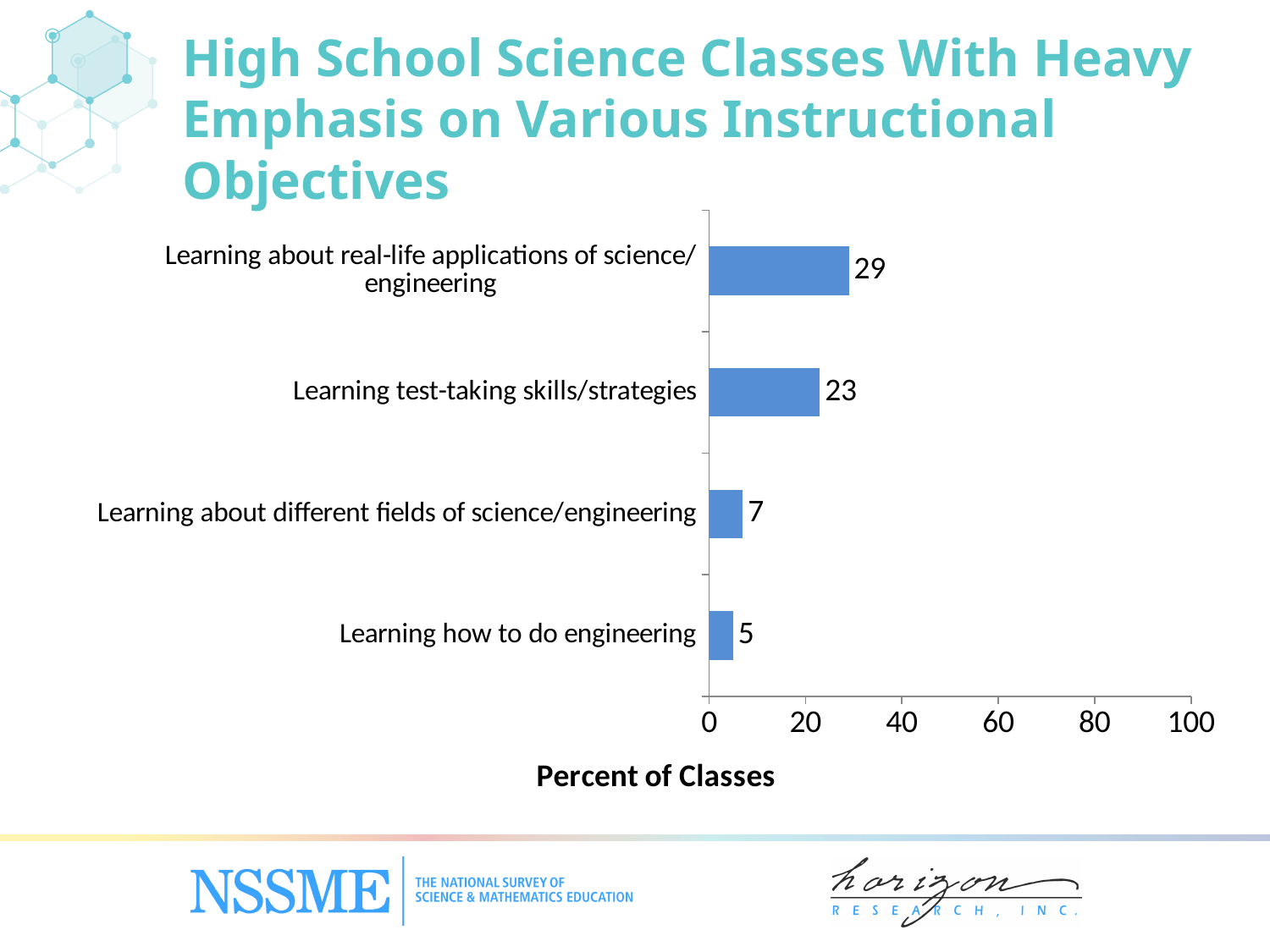
What kind of chart is shown on the slide? Bar chart Is the value for learning test-taking skills/strategies greater or less than 20? greater What percent of classes place heavy emphasis on learning test-taking skills/strategies? 23 How many instructional objectives are shown in the chart? 4 What percent of classes place heavy emphasis on learning about different fields of science/engineering? 7 What is the label of the horizontal axis? Percent of Classes What is the difference in percent of classes between learning about real-life applications of science/engineering and learning test-taking skills/strategies? 6 Which instructional objective has the highest percent of classes with heavy emphasis? Learning about real-life applications of science/engineering Which instructional objective has the lowest percent of classes with heavy emphasis? Learning how to do engineering What percent of classes place heavy emphasis on learning how to do engineering? 5 What percent of classes place heavy emphasis on learning about real-life applications of science/engineering? 29 Which has a higher percent of classes: learning about different fields of science/engineering or learning how to do engineering? Learning about different fields of science/engineering